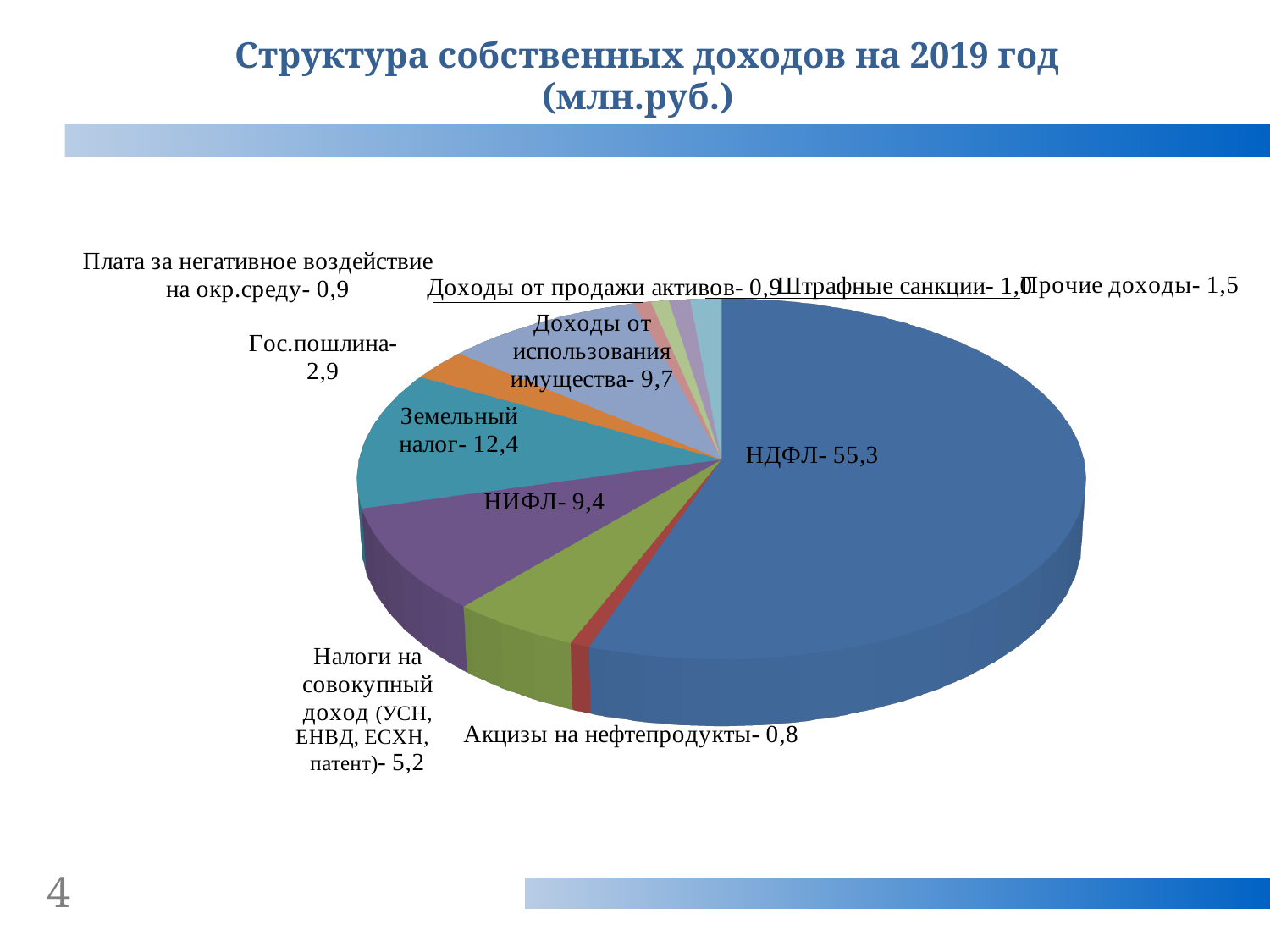
What is the value for Доходы от использования имущества? 9,7 What is the value for Налоги на совокупный доход (УСН, ЕНВД, ЕСХН, патент)? 5,2 Which category has the smallest value? Акцизы на нефтепродукты What is the value for НДФЛ? 55,3 What is the title of the chart on the slide? Структура собственных доходов на 2019 год (млн.руб.) Which category has the largest slice of the pie? НДФЛ What is the value for Гос.пошлина? 2,9 Which is larger, Доходы от использования имущества or НИФЛ? Доходы от использования имущества How many categories are shown in the pie chart? 11 What is the value for Земельный налог? 12,4 What is the difference between Земельный налог and НИФЛ? 3,0 What kind of chart is shown on the slide? pie chart